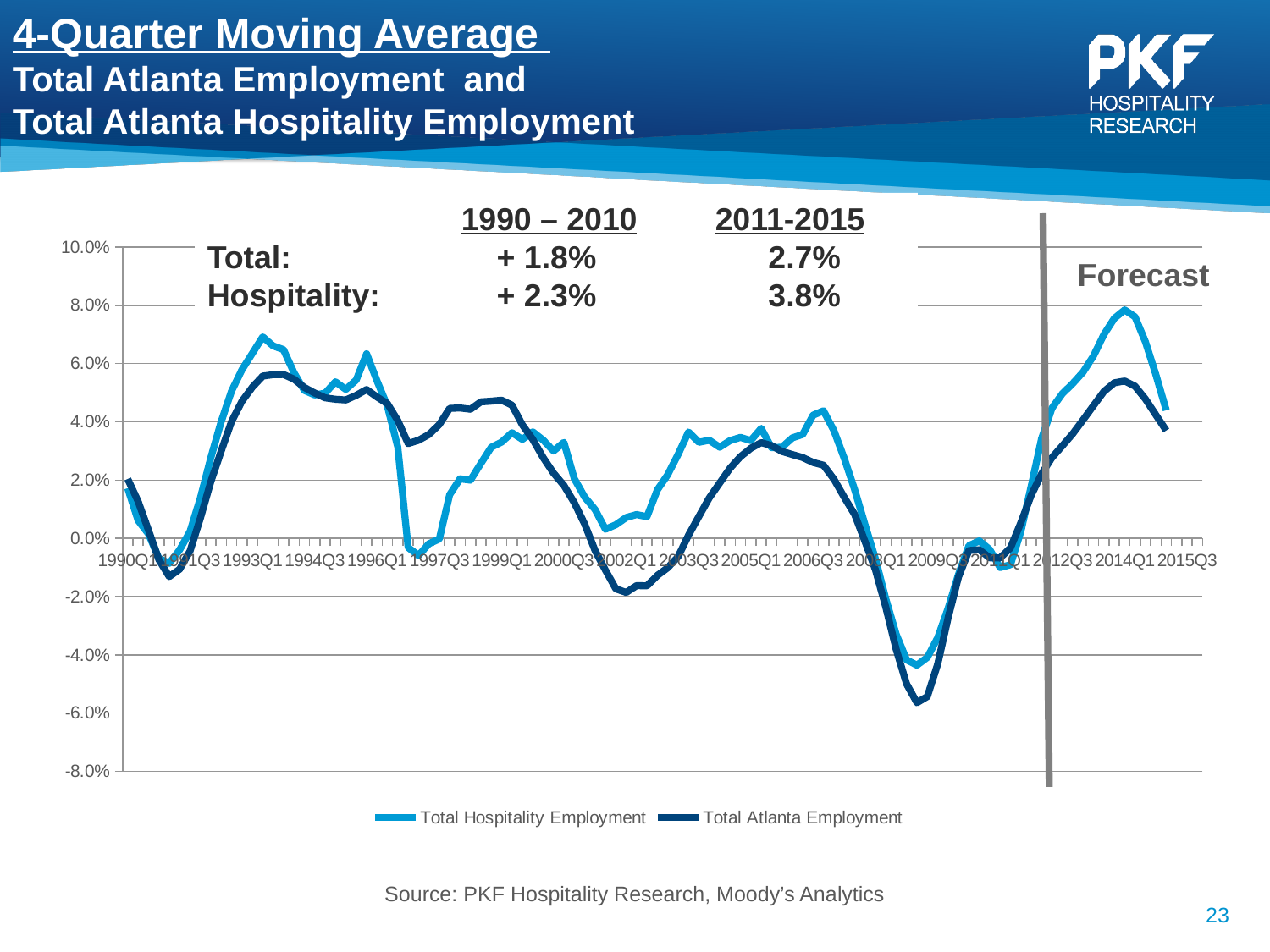
According to the text on the chart, what is the Hospitality figure for 2011-2015? 3.8% What is the difference between the Hospitality and Total figures for 2011-2015? 1.1% Is the lowest value of the Total Atlanta Employment line, around 2009, greater or less than -4.0%? less How many series does the legend list? 2 According to the text on the chart, what is the Total figure for 2011-2015? 2.7% Which series reaches the lower value at the trough around 2009, Total Hospitality Employment or Total Atlanta Employment? Total Atlanta Employment According to the text on the chart, what was the Hospitality average for 1990 – 2010? + 2.3% What kind of chart is shown on the slide? line chart Is the peak of the Total Hospitality Employment line around 2014Q1 greater or less than 6.0%? greater What are the two series named in the legend? Total Hospitality Employment and Total Atlanta Employment According to the text on the chart, what was the Total average for 1990 – 2010? + 1.8% Which is larger for 2011-2015, the Total figure or the Hospitality figure? Hospitality